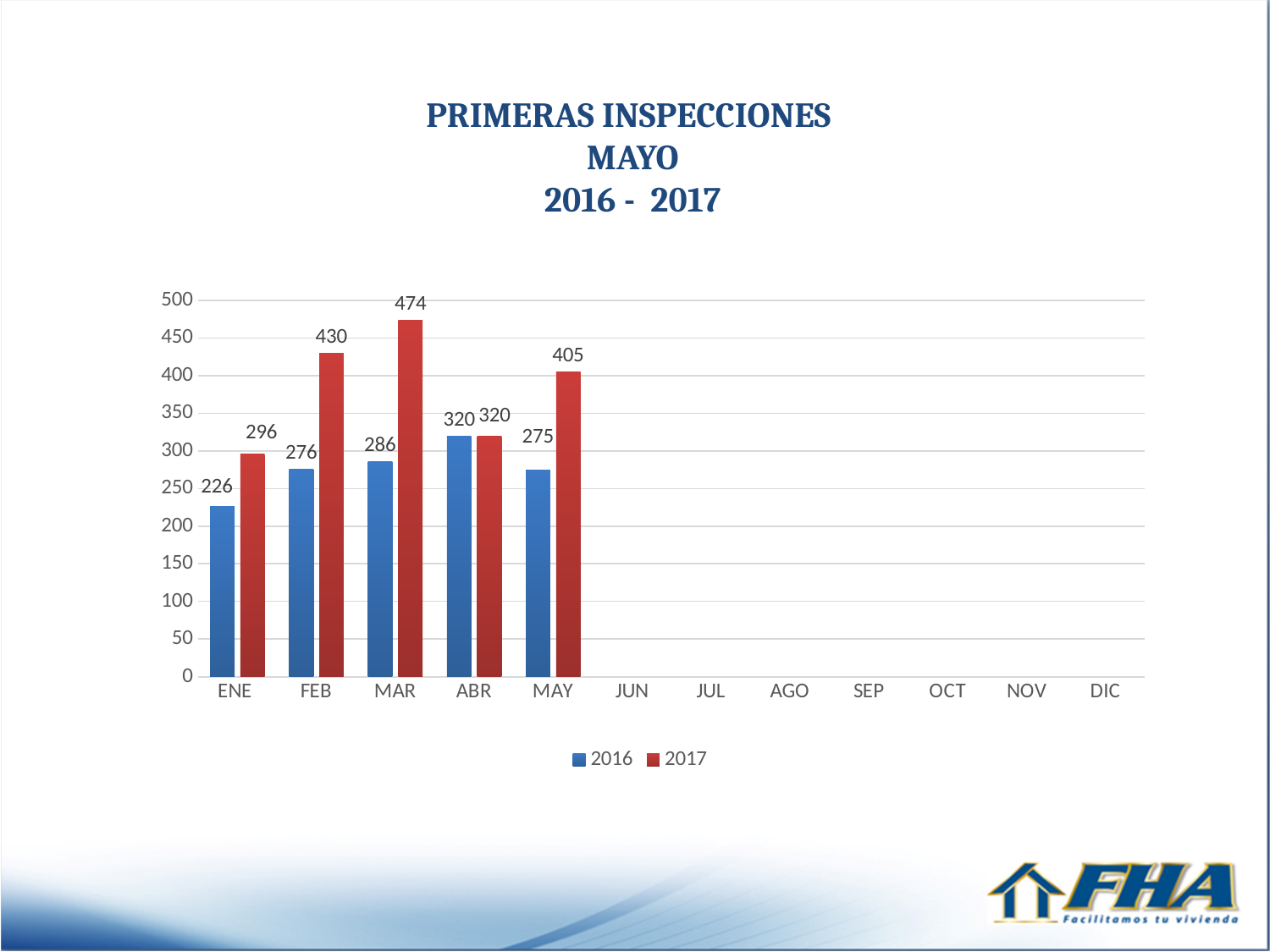
Is the 2017 value for ENE greater or less than 250? greater What kind of chart is shown on the slide? bar chart How many months have data plotted for both series? 5 What colour represents the 2016 series? blue Which is larger in MAY, the 2016 value or the 2017 value? 2017 Which month has the highest value for the 2017 series? MAR Which month has the lowest value for the 2016 series? ENE How many series does the legend list? 2 What is the value for 2017 in MAY? 405 What is the value for 2016 in ENE? 226 What is the difference between the 2017 and 2016 values in FEB? 154 What is the value for 2017 in MAR? 474